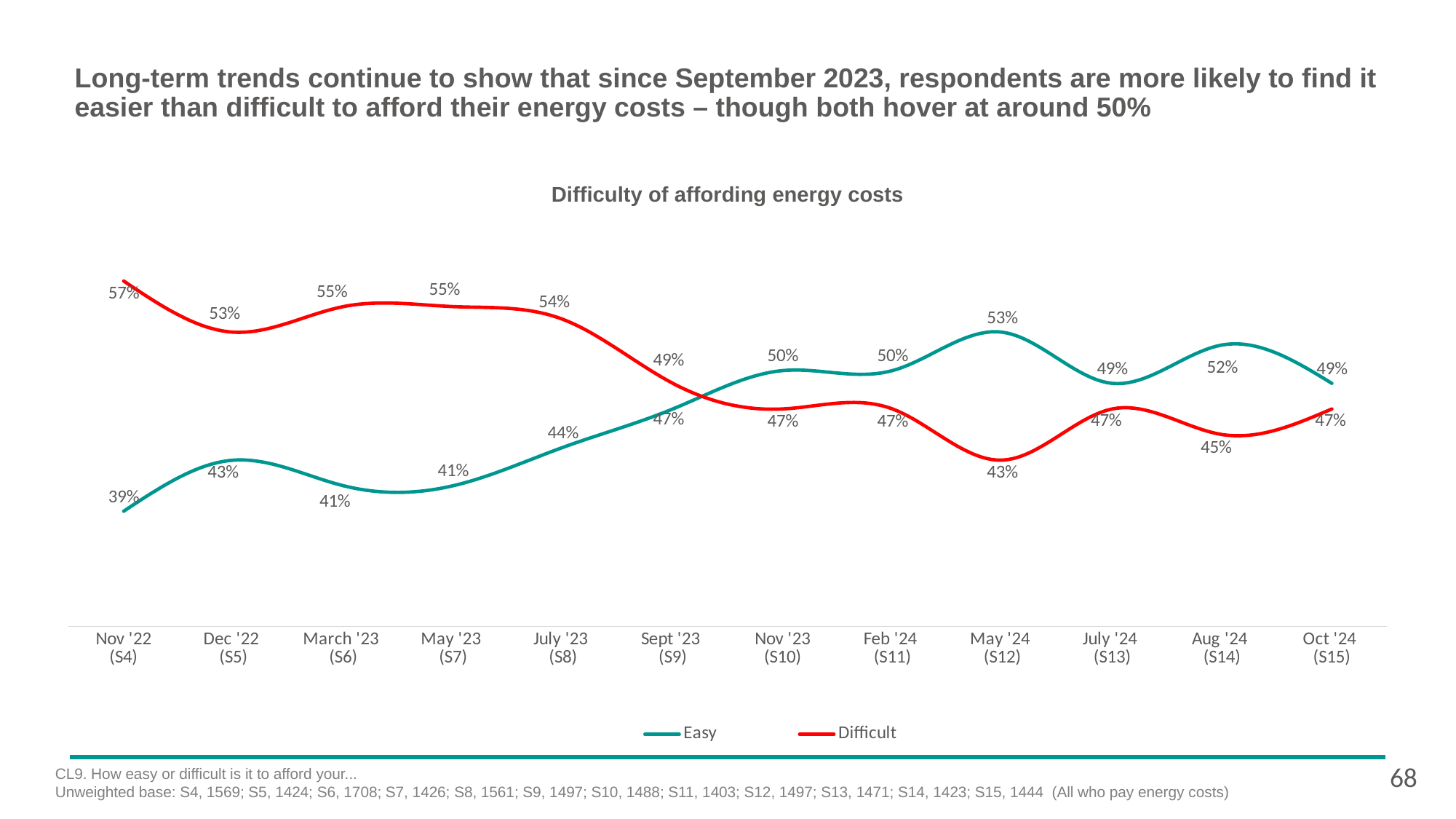
In Oct '24 (S15), which is larger: Easy or Difficult? Easy What kind of chart is shown? Line chart In which wave is the Difficult series at its highest? Nov '22 (S4) What is the difference between the Difficult and Easy values in Nov '22 (S4)? 18 percentage points Does the Difficult series rise or fall between Nov '22 (S4) and Sept '23 (S9)? Fall What is the value for Difficult in Nov '22 (S4)? 57% What is the value for Easy in May '24 (S12)? 53% How many time points are plotted on the x axis? 12 What is the value for Easy in Nov '22 (S4)? 39% What is the value for Difficult in Aug '24 (S14)? 45% How many series does the legend list? 2 In which wave is the Easy series at its lowest? Nov '22 (S4)